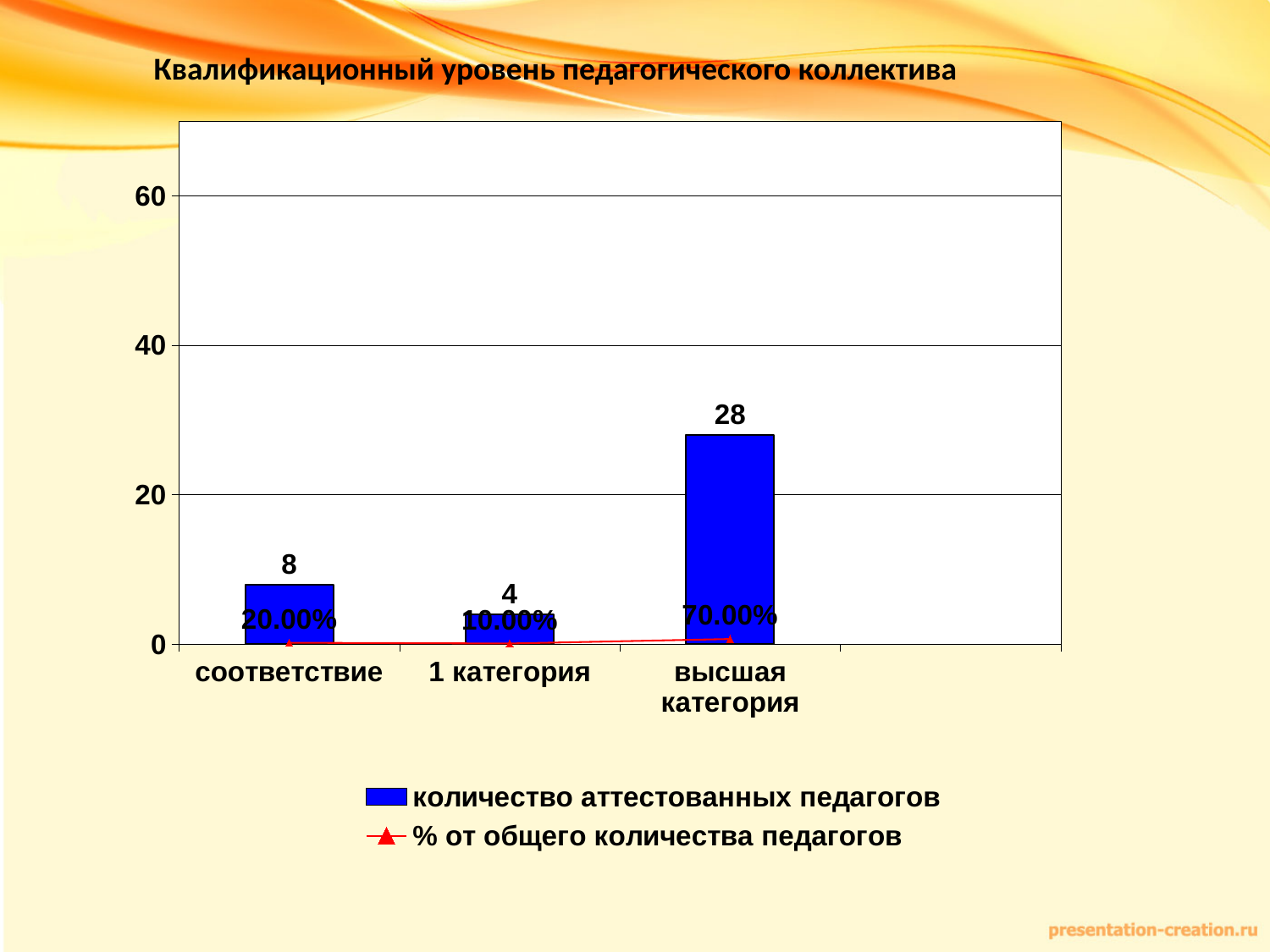
What is the '% от общего количества педагогов' value for 'соответствие'? 20.00% What is the value of 'количество аттестованных педагогов' for 'соответствие'? 8 Is the value of 'количество аттестованных педагогов' for 'высшая категория' greater or less than 20? greater Which category has the highest number of 'количество аттестованных педагогов'? высшая категория Which category has the lowest number of 'количество аттестованных педагогов'? 1 категория What is the '% от общего количества педагогов' value for 'высшая категория'? 70.00% How many series does the legend list? 2 What is the value of 'количество аттестованных педагогов' for 'высшая категория'? 28 What is the value of 'количество аттестованных педагогов' for '1 категория'? 4 How many categories are shown on the x axis? 3 What is the difference in 'количество аттестованных педагогов' between 'высшая категория' and 'соответствие'? 20 Which is larger: 'количество аттестованных педагогов' for 'соответствие' or for '1 категория'? соответствие